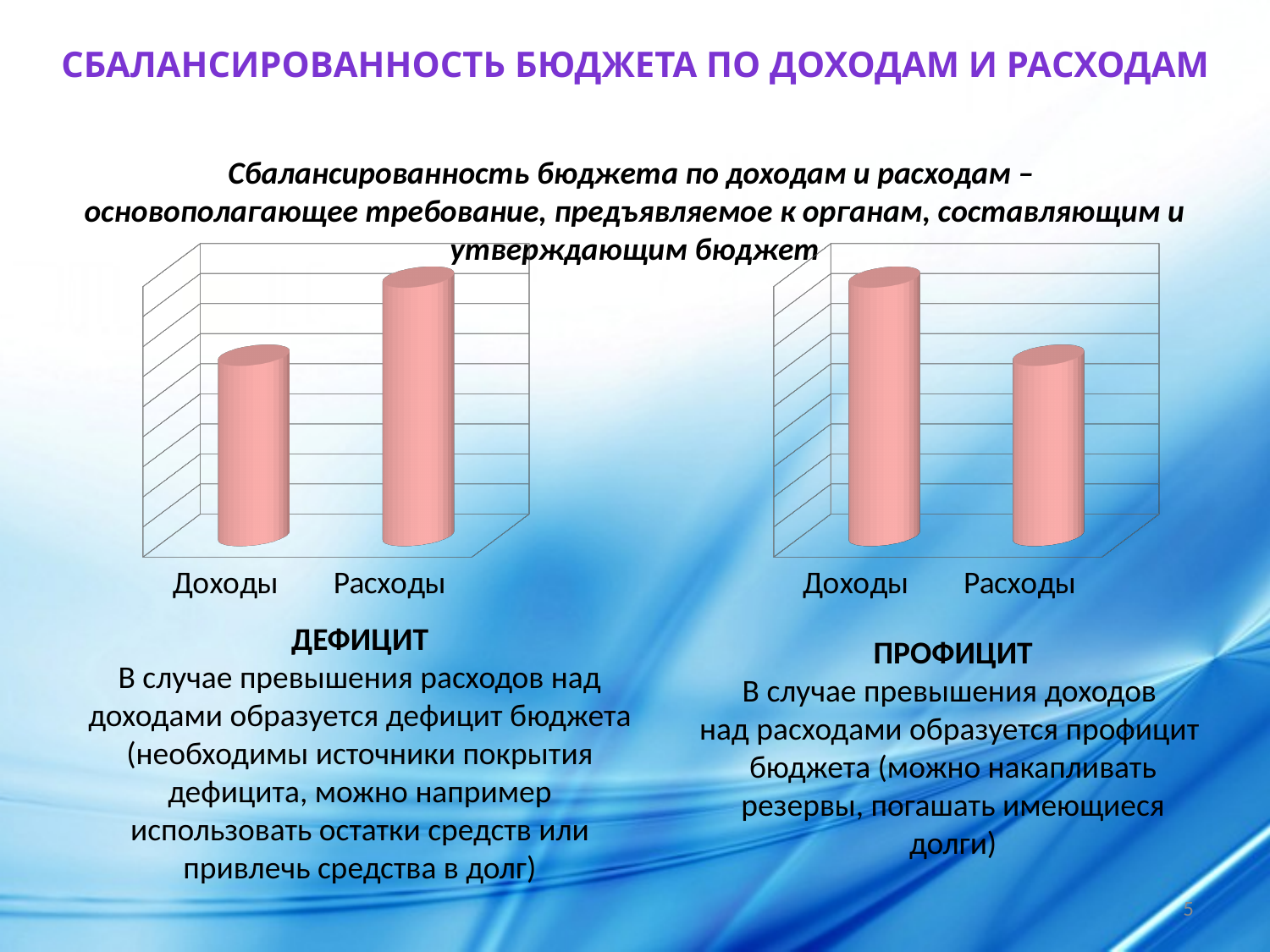
In the left chart, which is larger: Доходы or Расходы? Расходы In the left chart, which category has the highest bar? Расходы In the right chart, which is larger: Доходы or Расходы? Доходы What colour are the bars in both charts? pink In the right chart, do the bars rise or fall from Доходы to Расходы? fall What kind of chart is the right chart on the slide? bar chart In the right chart, which category has the lowest bar? Расходы In the right chart, which category has the highest bar? Доходы In the left chart, which category has the lowest bar? Доходы How many categories does the left chart show? 2 How many categories does the right chart show? 2 What kind of chart is the left chart on the slide? bar chart